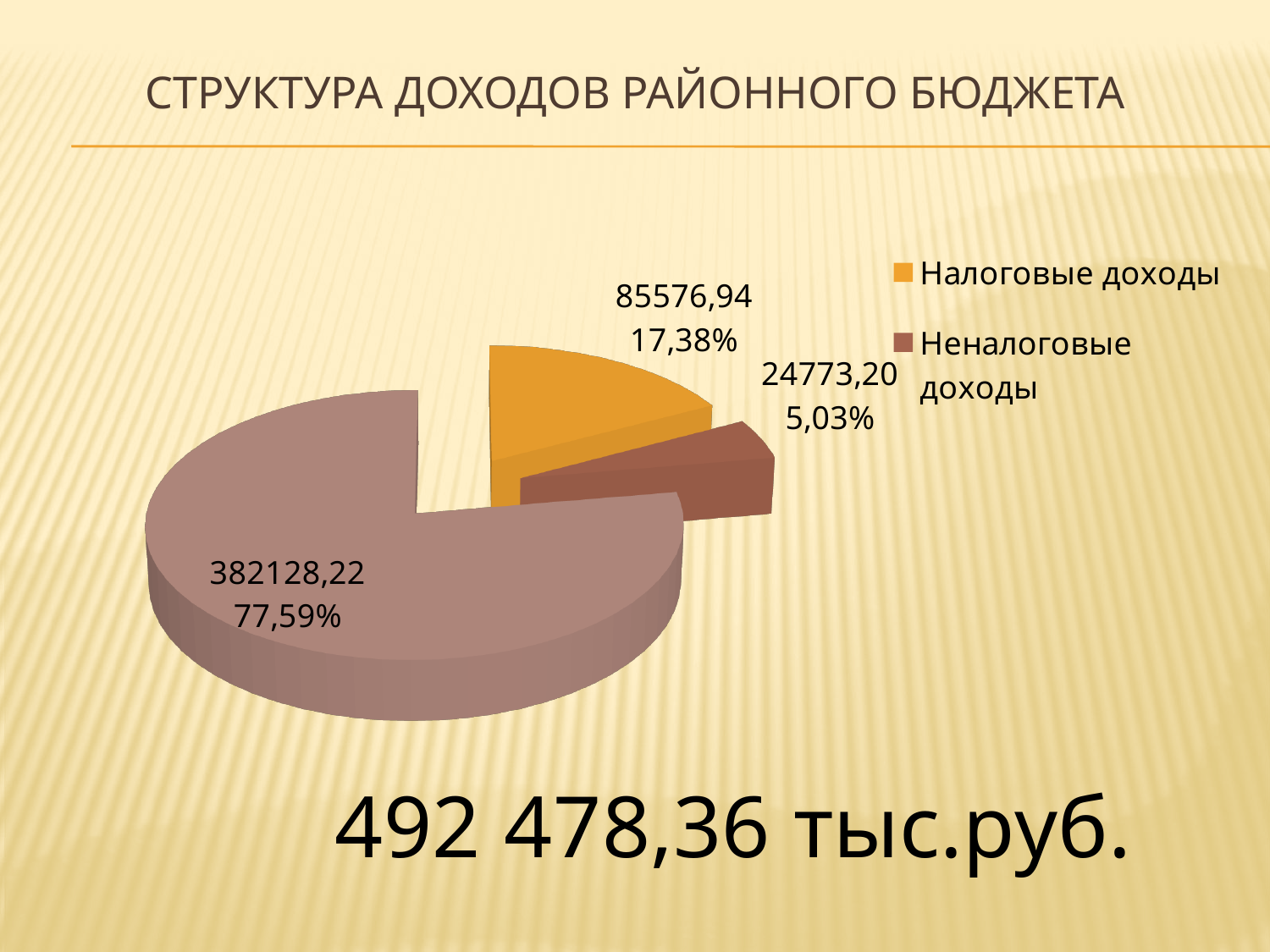
What value is printed for Неналоговые доходы? 24773,20 What kind of chart is shown on the slide? pie chart What is the difference between the values for Налоговые доходы and Неналоговые доходы? 60803,74 How many entries does the legend list? 2 Which is larger, Налоговые доходы or Неналоговые доходы? Налоговые доходы What share of the pie is Налоговые доходы? 17,38% How many slices does the pie chart have? 3 What percentage is printed on the largest slice of the pie? 77,59% What value is printed on the largest slice of the pie? 382128,22 What value is printed for Налоговые доходы? 85576,94 What is the title of the slide? СТРУКТУРА ДОХОДОВ РАЙОННОГО БЮДЖЕТА What share of the pie is Неналоговые доходы? 5,03%